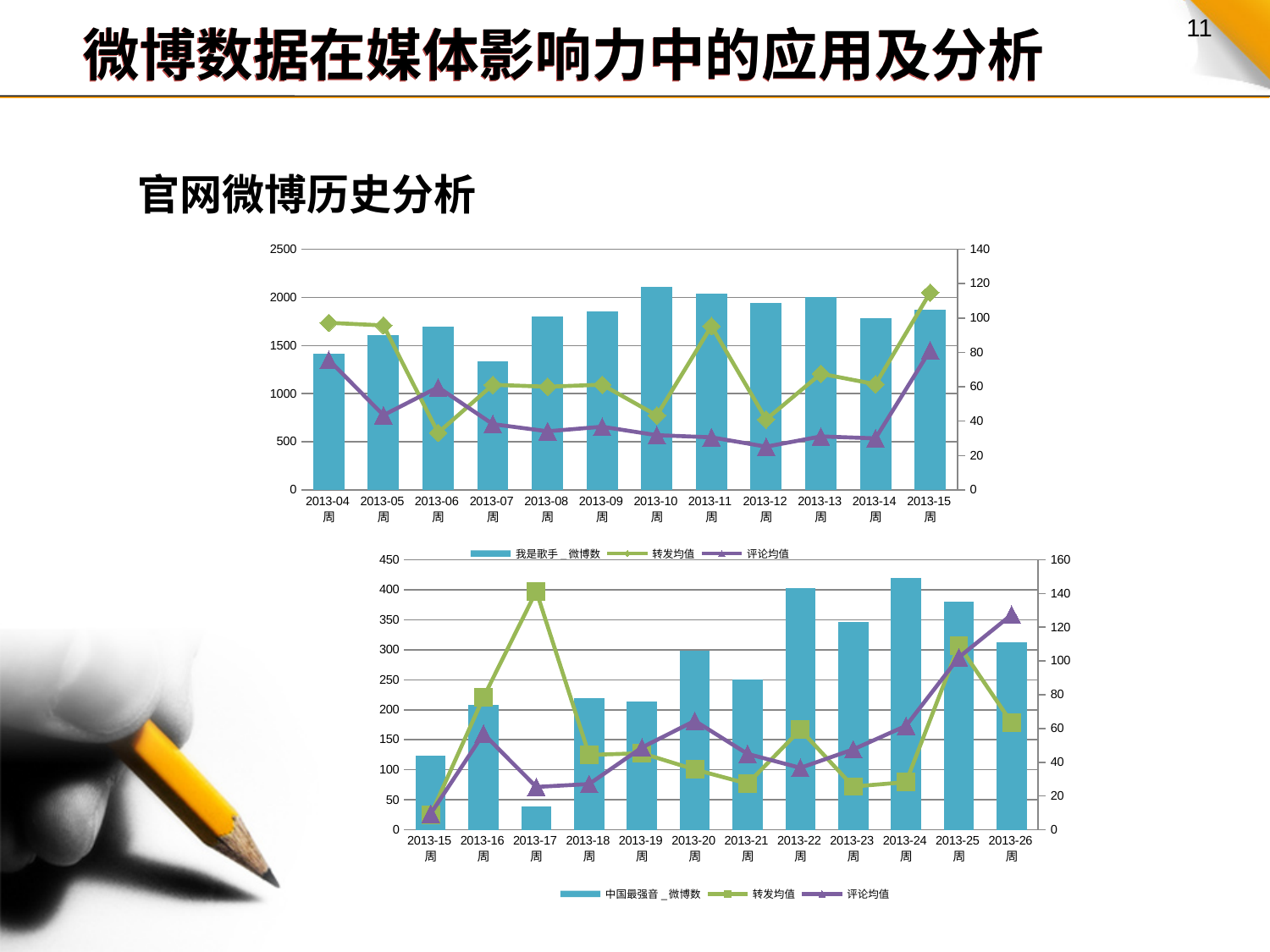
In the bottom chart (中国最强音_微博数), at which week does the 转发均值 line reach its highest point? 2013-17周 In the bottom chart (中国最强音_微博数), how many weeks are shown on the x axis? 12 In the top chart (我是歌手_微博数), is the bar for 2013-07周 greater or less than 1500? less In the top chart (我是歌手_微博数), at which week does the 转发均值 line reach its highest point? 2013-15周 In the bottom chart (中国最强音_微博数), which week has the tallest bar? 2013-24周 In the top chart (我是歌手_微博数), which week has the shortest bar? 2013-07周 In the bottom chart (中国最强音_微博数), which week has the shortest bar? 2013-17周 In the top chart (我是歌手_微博数), how many series does the legend list? 3 In the bottom chart (中国最强音_微博数), which bar is taller: 2013-16周 or 2013-20周? 2013-20周 In the top chart (我是歌手_微博数), is the bar for 2013-10周 greater or less than 2000? greater In the bottom chart (中国最强音_微博数), is the bar for 2013-17周 greater or less than 50? less